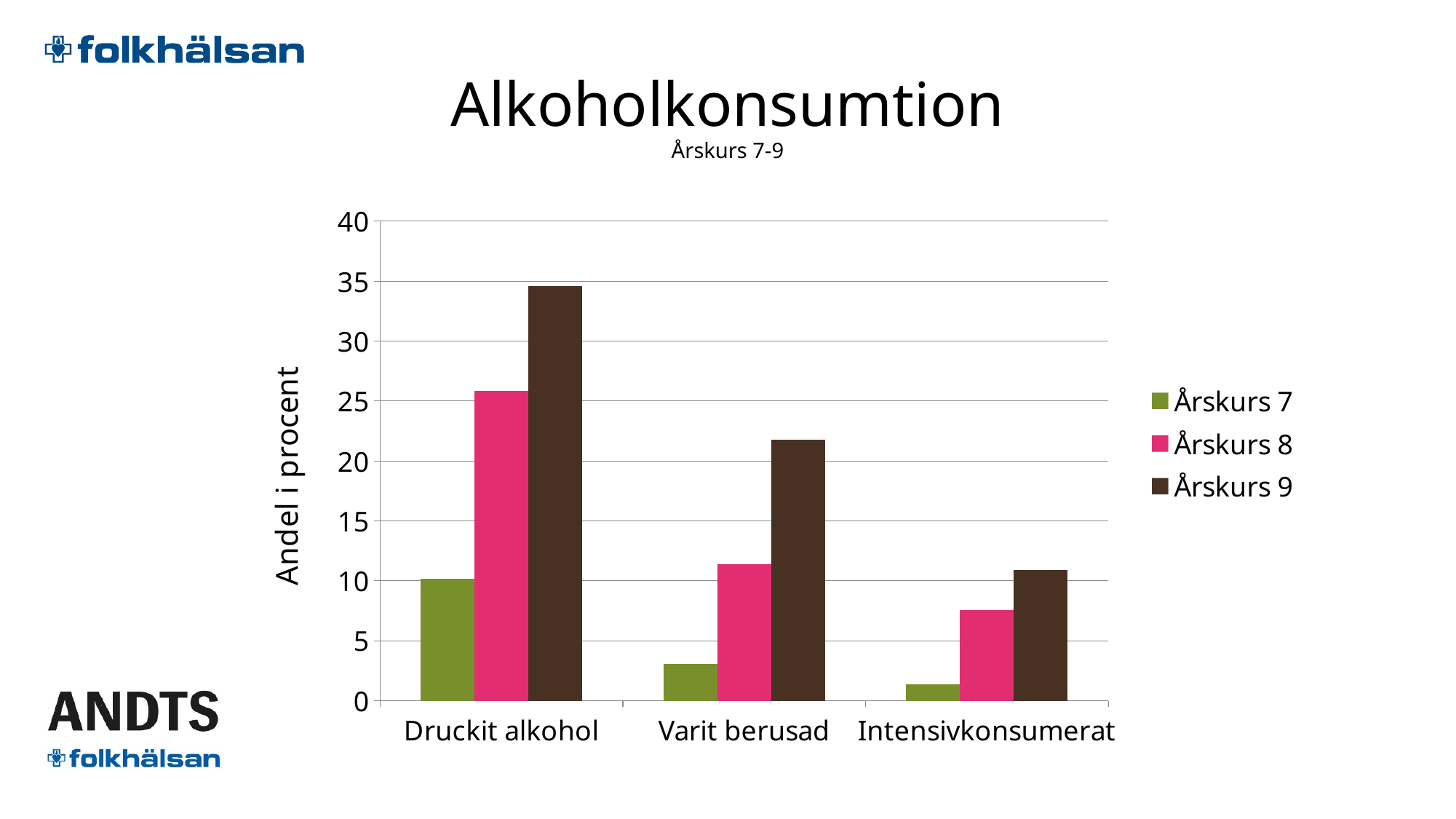
Is the value for Årskurs 8 in Druckit alkohol greater or less than 20? greater How many categories are shown on the x axis? 3 Is the value for Årskurs 9 in Varit berusad greater or less than 20? greater In which category is the Årskurs 9 bar highest? Druckit alkohol Is the value for Årskurs 9 in Druckit alkohol greater or less than 30? greater Which is larger: Årskurs 8 in Druckit alkohol or Årskurs 9 in Varit berusad? Årskurs 8 in Druckit alkohol What is the title of the y axis? Andel i procent How many series does the legend list? 3 In which category is the Årskurs 7 bar lowest? Intensivkonsumerat What kind of chart is shown on the slide? bar chart